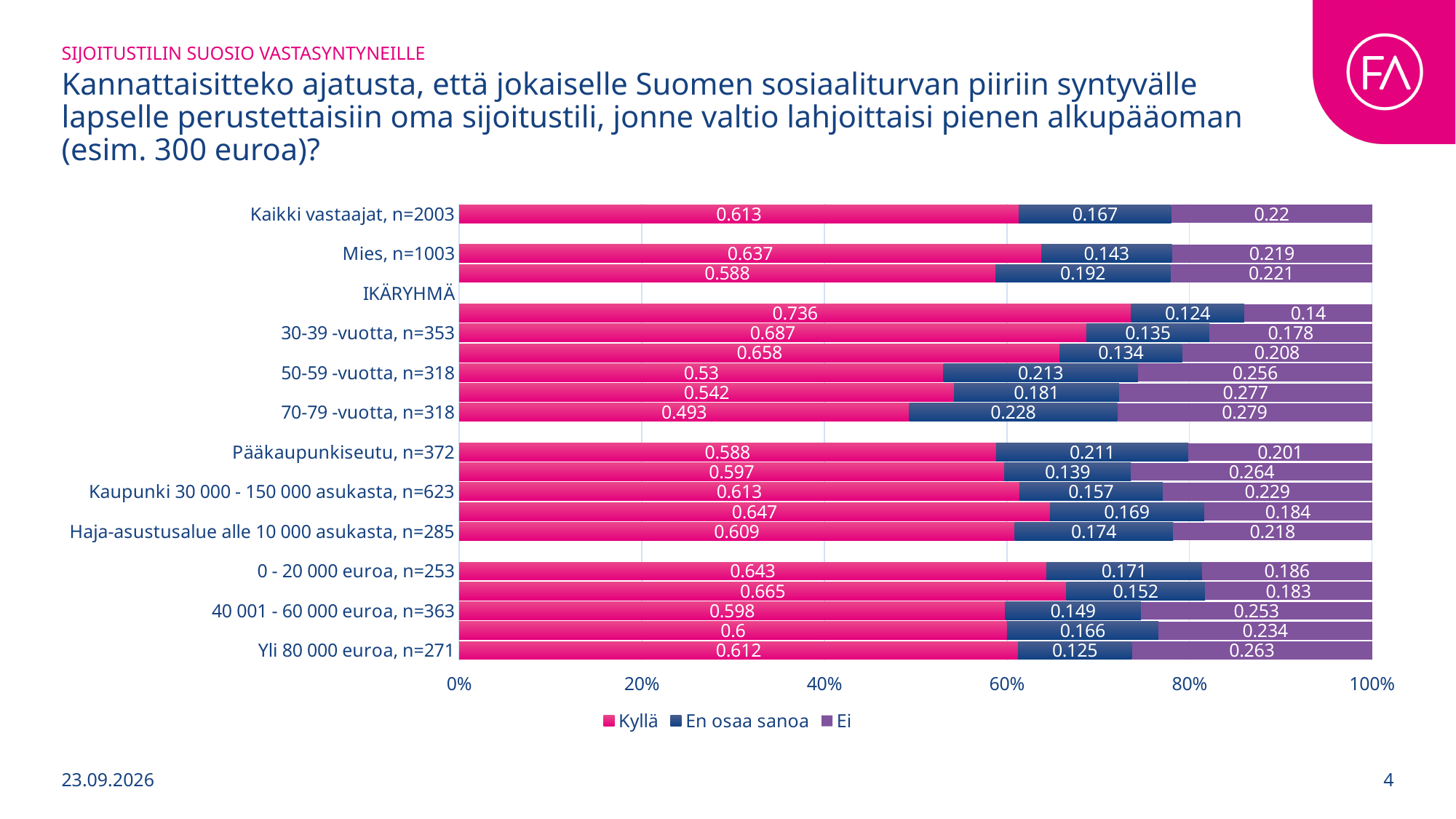
Which labelled group has the highest En osaa sanoa value? 70-79 -vuotta, n=318 What is the Kyllä value for Yli 80 000 euroa, n=271? 0.612 Is the Kyllä value for 0 - 20 000 euroa, n=253 greater or less than 60%? greater Which labelled group has the lowest Kyllä value? 70-79 -vuotta, n=318 Which has a larger Ei value: Pääkaupunkiseutu, n=372 or Haja-asustusalue alle 10 000 asukasta, n=285? Haja-asustusalue alle 10 000 asukasta, n=285 What is the Ei value for Mies, n=1003? 0.219 What is the Kyllä value for Kaikki vastaajat, n=2003? 0.613 How many series does the legend list? 3 What is the difference between the Kyllä values for 30-39 -vuotta, n=353 and 70-79 -vuotta, n=318? 0.194 What is the En osaa sanoa value for 50-59 -vuotta, n=318? 0.213 What are the three series named in the legend? Kyllä, En osaa sanoa, Ei What kind of chart is shown on the slide? stacked bar chart